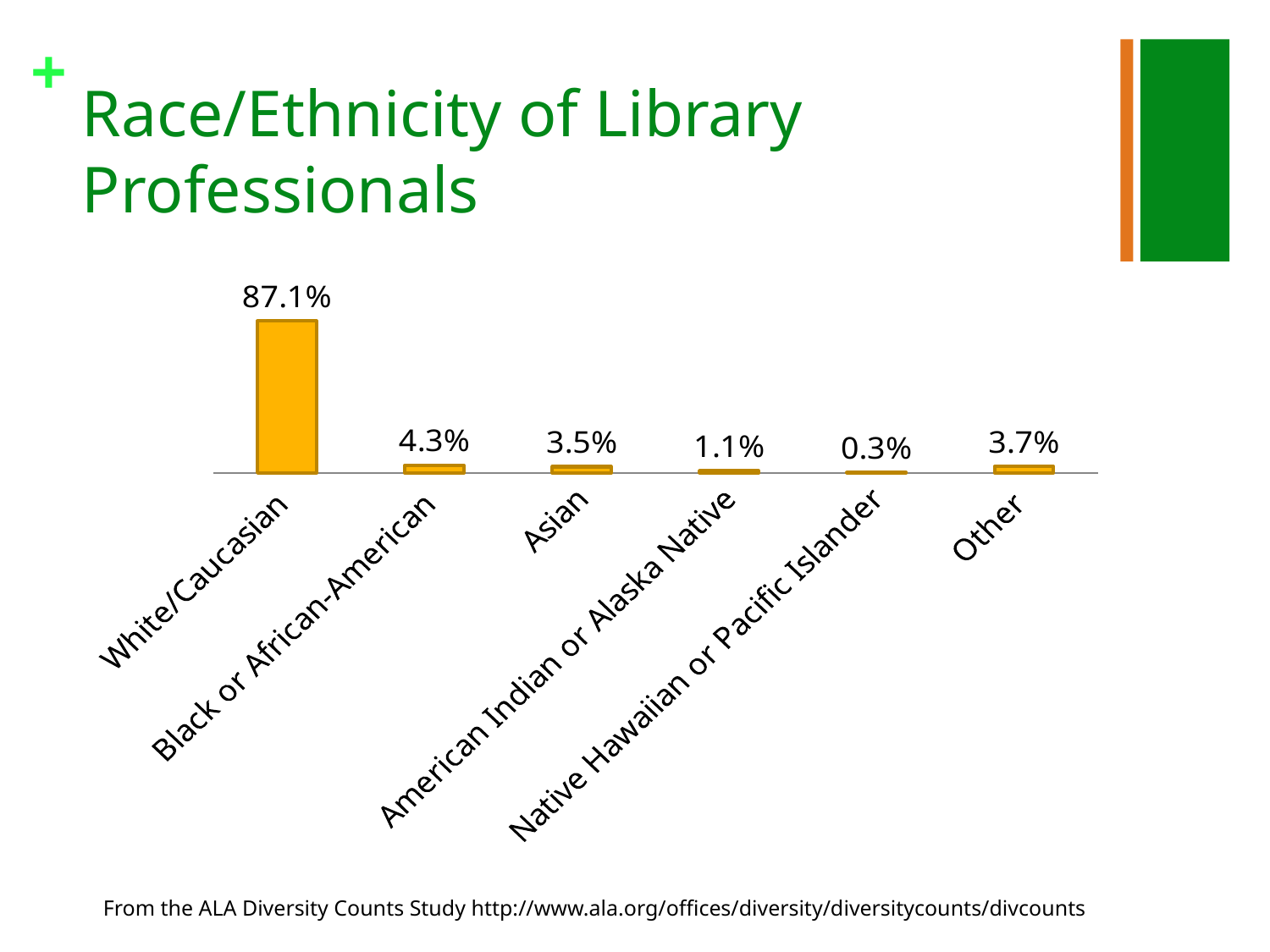
How many categories are shown in the chart? 6 What is the value for American Indian or Alaska Native? 1.1% What is the value for Other? 3.7% Which category has the lowest value? Native Hawaiian or Pacific Islander What kind of chart is shown on the slide? Bar chart What is the value for Native Hawaiian or Pacific Islander? 0.3% Which is larger, the value for Other or the value for Asian? Other What is the value for Black or African-American? 4.3% What is the value for White/Caucasian? 87.1% What is the difference between the values for White/Caucasian and Black or African-American? 82.8% What is the value for Asian? 3.5% Which category has the highest value? White/Caucasian